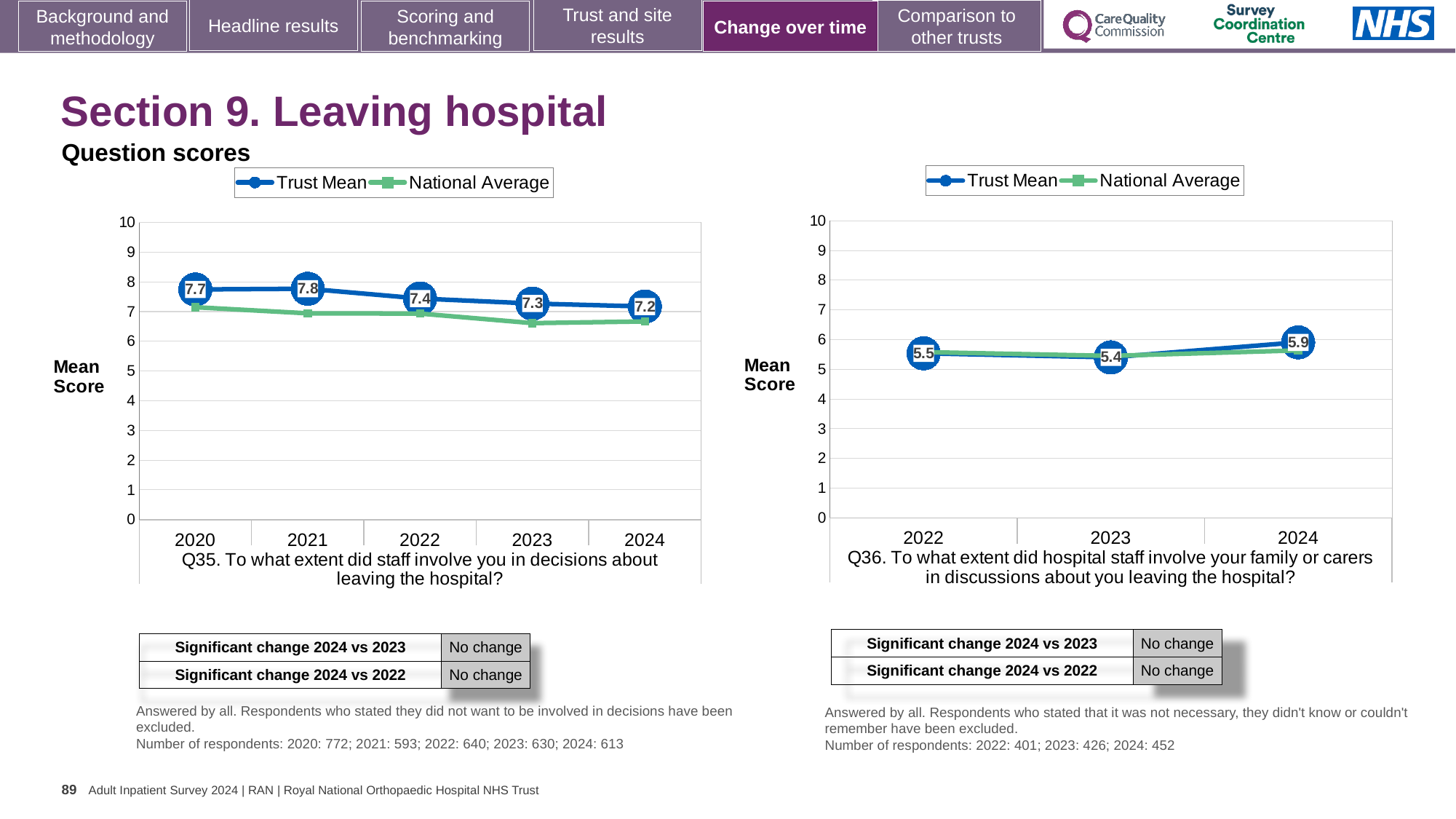
In the Q36 chart (right), which year has the highest Trust Mean score? 2024 How many years are plotted on the x axis of the Q36 chart (right)? 3 In the Q35 chart (left), what is the Trust Mean score for 2021? 7.8 In the Q36 chart (right), what is the Trust Mean score for 2023? 5.4 What type of chart is used for Q35 (left)? Line chart In the Q35 chart (left), what is the Trust Mean score for 2024? 7.2 In the Q35 chart (left), which year has the lowest Trust Mean score? 2024 How many series does the legend of the Q35 chart (left) list? 2 In the Q36 chart (right), what is the difference between the Trust Mean scores for 2024 and 2023? 0.5 In the Q35 chart (left), what is the difference between the Trust Mean scores for 2021 and 2024? 0.6 In the Q35 chart (left), is the Trust Mean for 2020 or 2023 higher? 2020 In the Q35 chart (left), is the National Average for 2023 greater or less than 7? less